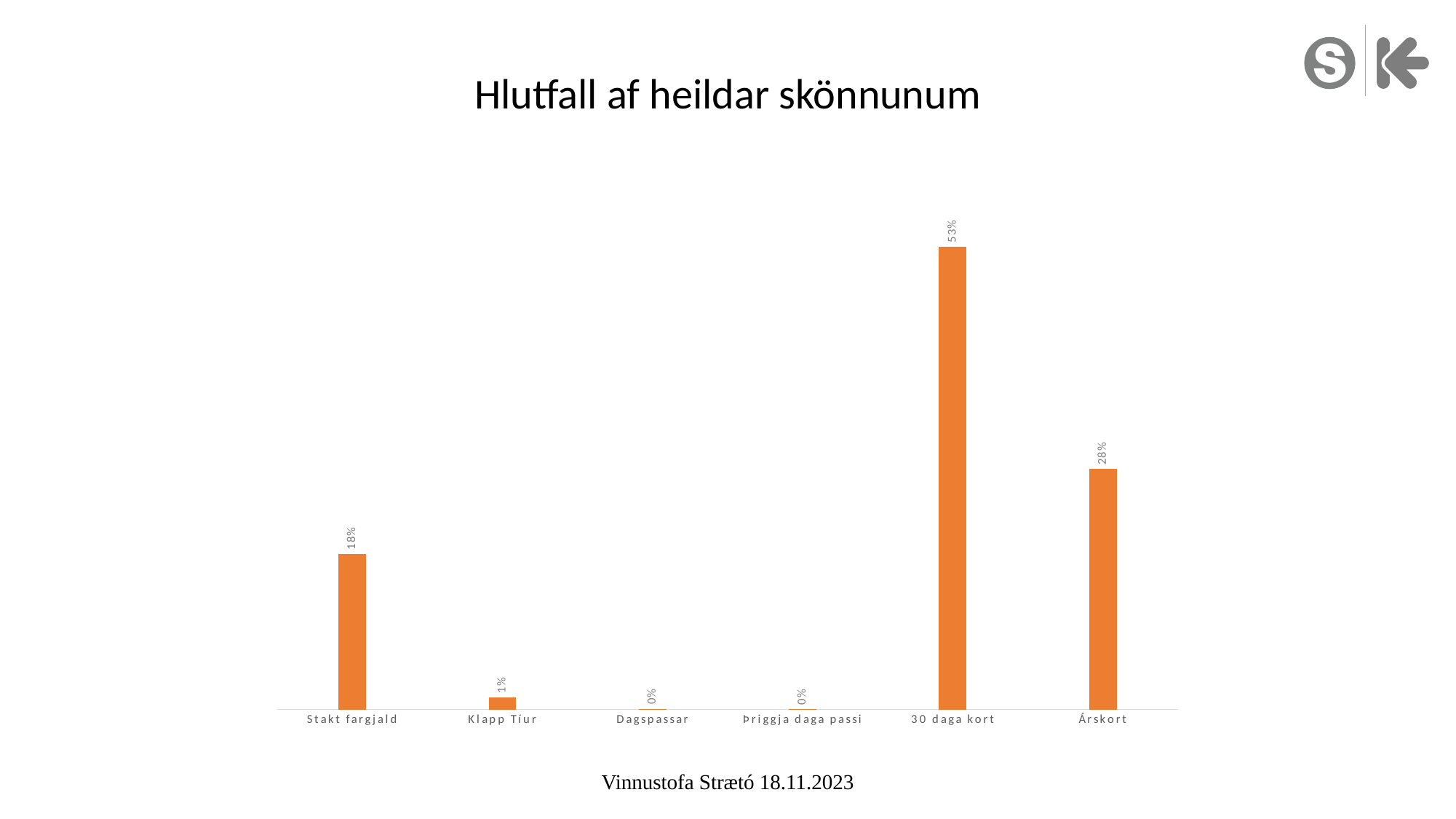
What is the difference between the values for Árskort and Stakt fargjald? 10% Which is larger, the value for Stakt fargjald or the value for Árskort? Árskort What is the value for 30 daga kort? 53% Which category has the highest value? 30 daga kort How many categories are shown on the x axis? 6 What is the value for Stakt fargjald? 18% What is the value for Árskort? 28% What kind of chart is shown on the slide? bar chart What is the value for Dagspassar? 0% What is the value for Klapp Tíur? 1% What is the title of the chart? Hlutfall af heildar skönnunum What is the difference between the values for 30 daga kort and Árskort? 25%